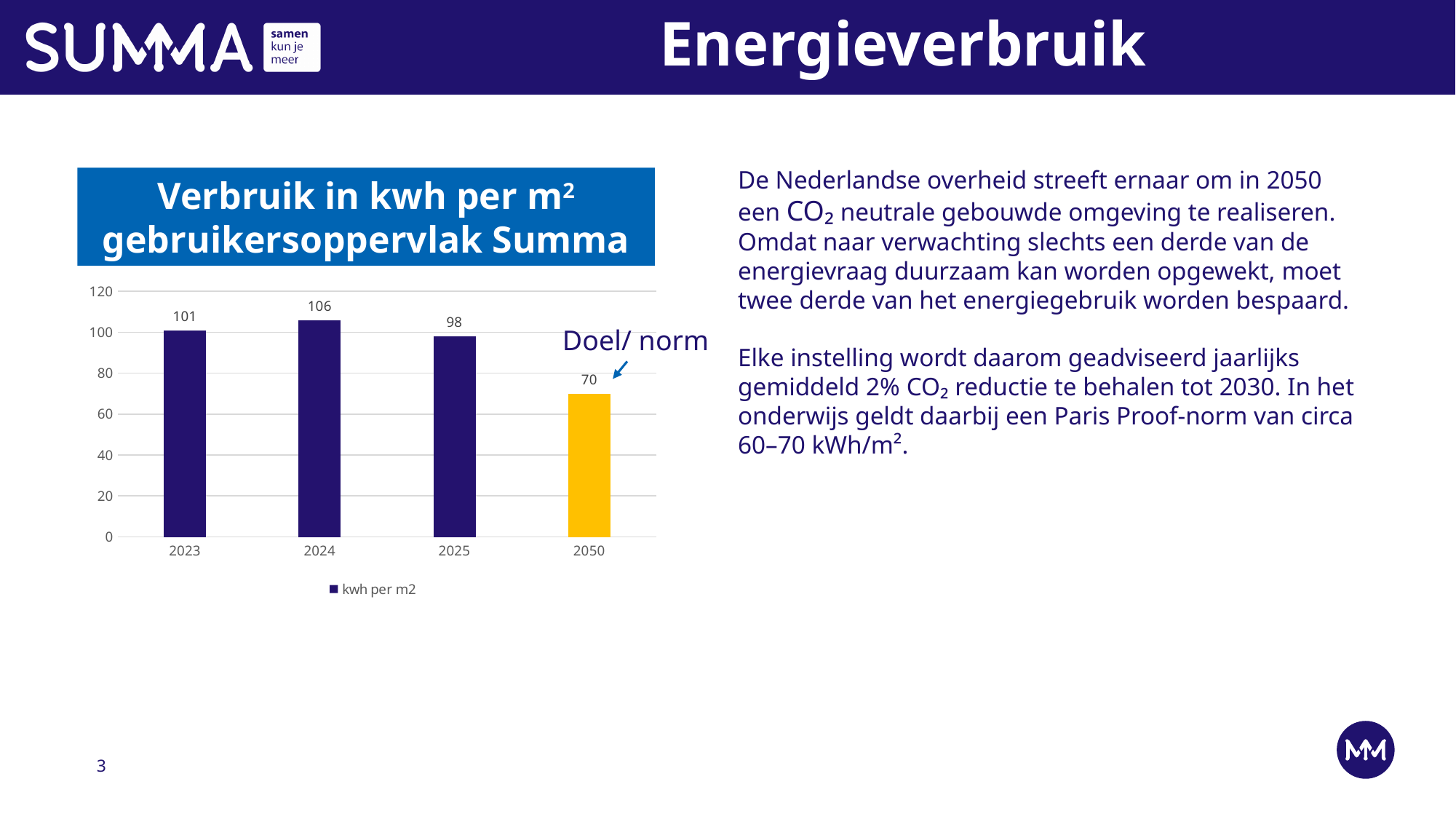
What is the value for 2024? 106 Which year has the lowest value? 2050 What is the value for 2025? 98 What is the value for 2023? 101 What is the difference between the values for 2023 and 2050? 31 How many bars are shown in the chart? 4 What is the title of the chart? Verbruik in kwh per m² gebruikersoppervlak Summa What kind of chart is shown on the slide? bar chart Which year has the highest value? 2024 Which is larger, the value for 2023 or the value for 2025? 2023 What is the difference between the values for 2024 and 2025? 8 What is the value for 2050? 70